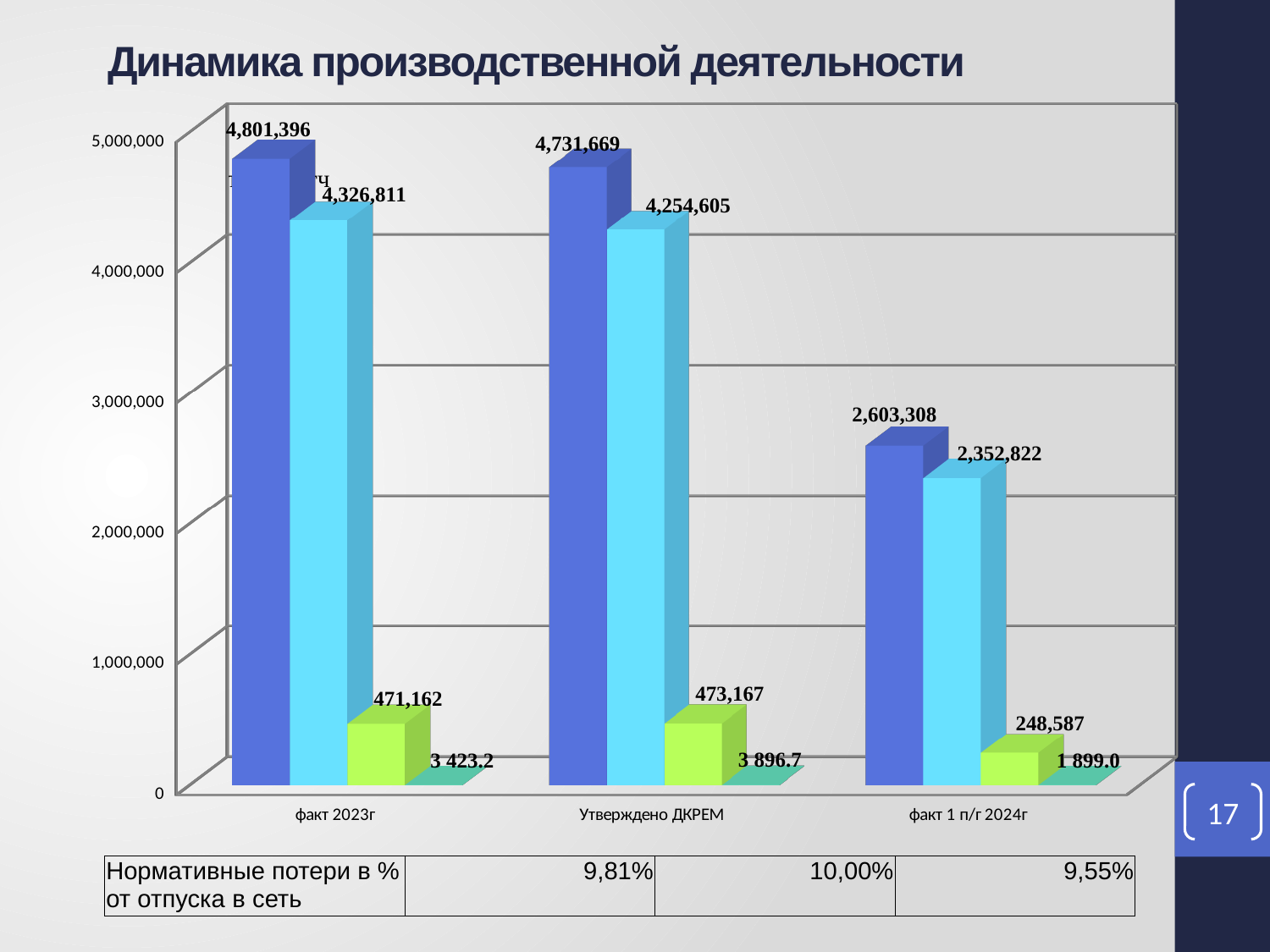
How many categories are shown on the x axis? 3 Which category has the highest dark blue bar? факт 2023г What is the difference between the dark blue bars for факт 2023г and Утверждено ДКРЕМ? 69,727 What is the value of the light blue bar for Утверждено ДКРЕМ? 4,254,605 What is the title of the chart? Динамика производственной деятельности What is the value of the dark blue bar for факт 2023г? 4,801,396 What is the value of the teal bar for факт 2023г? 3 423.2 What kind of chart is shown on the slide? bar chart Which category has the lowest light blue bar? факт 1 п/г 2024г Which is larger: the green bar for факт 2023г or the green bar for Утверждено ДКРЕМ? Утверждено ДКРЕМ What is the value of the green bar for факт 1 п/г 2024г? 248,587 Is the value of the light blue bar for факт 1 п/г 2024г greater or less than 3,000,000? less